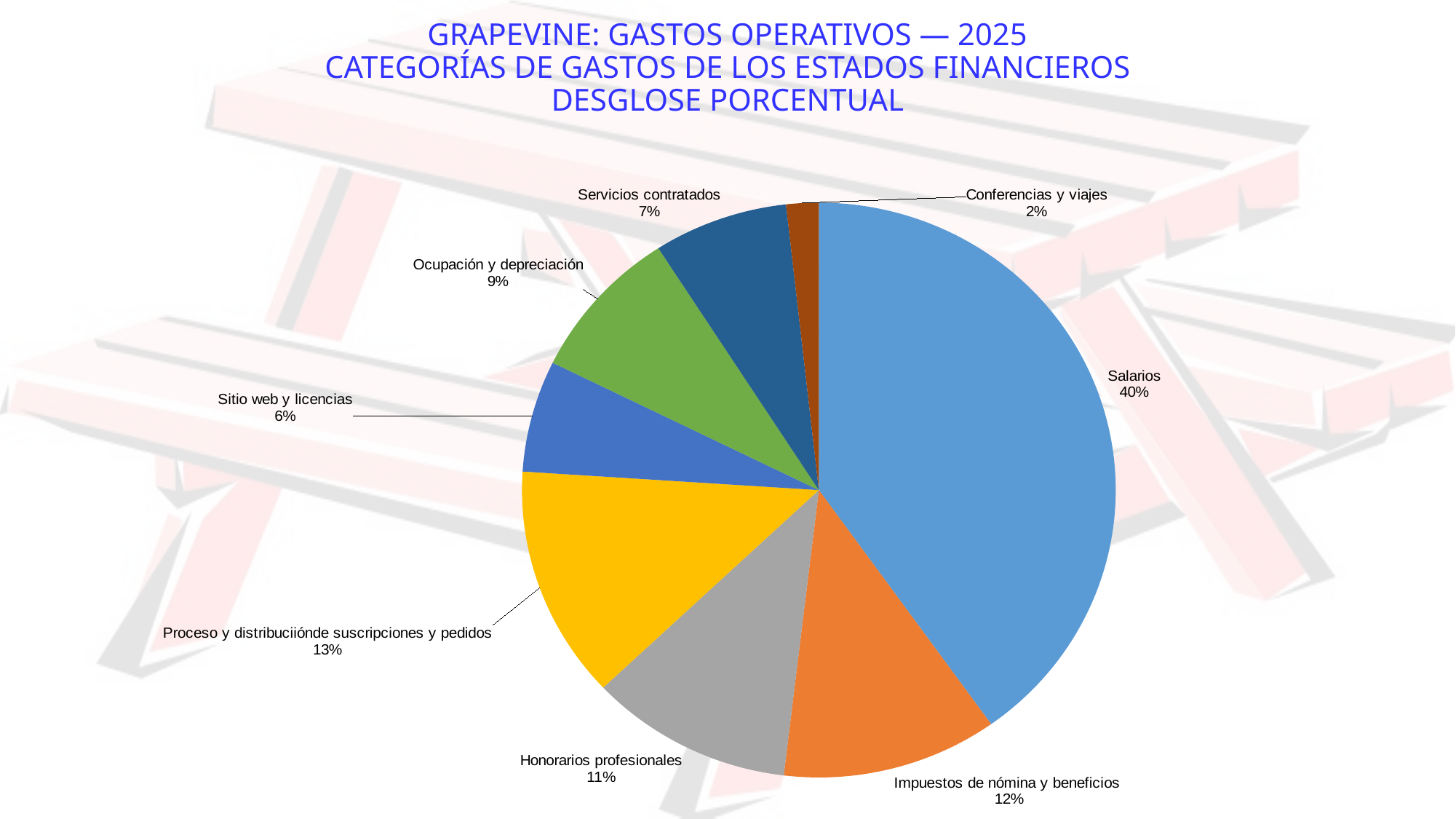
Which is larger, Ocupación y depreciación or Servicios contratados? Ocupación y depreciación What kind of chart is shown on the slide? Pie chart What is the combined share of Sitio web y licencias and Servicios contratados? 13% What percentage is shown for Conferencias y viajes? 2% What is the difference in percentage points between Salarios and Honorarios profesionales? 29 What percentage of operating expenses is Salarios? 40% What year is given in the chart title? 2025 Which category has the largest share of the pie? Salarios How many categories are shown in the pie chart? 8 What is the percentage for Impuestos de nómina y beneficios? 12% What share does Proceso y distribuciiónde suscripciones y pedidos represent? 13% Which category has the smallest share of the pie? Conferencias y viajes